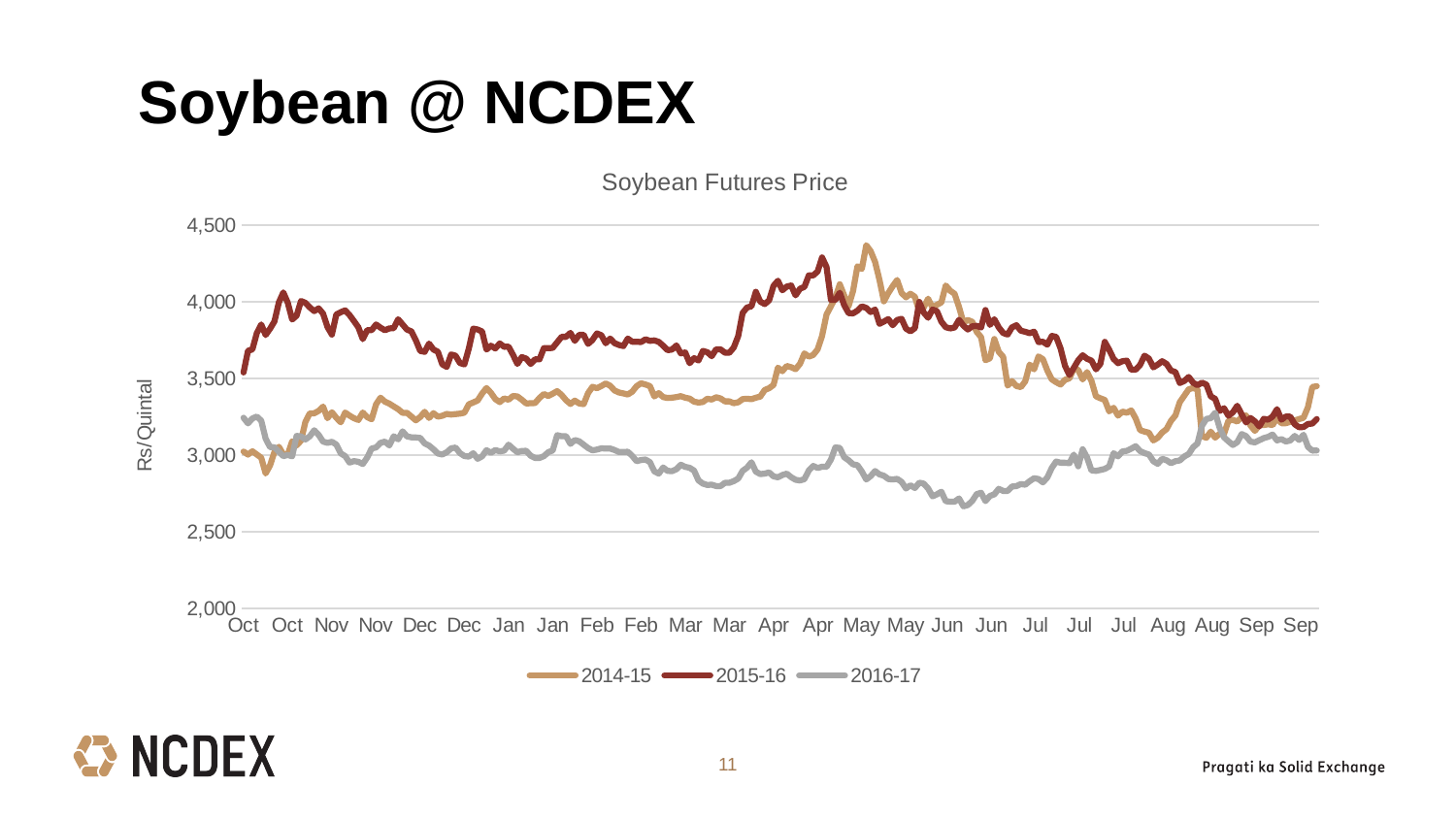
What is the label on the vertical axis of the chart? Rs/Quintal In Jan, which series has the higher value, 2015-16 or 2016-17? 2015-16 Is the value for the 2015-16 series in Nov greater or less than 3,500? greater Is the peak value of the 2014-15 series in May greater or less than 4,000? greater Which series has the lowest values across most of the chart? 2016-17 How many series does the legend of the Soybean Futures Price chart list? 3 What is the title of the chart? Soybean Futures Price Does the 2016-17 series rise or fall from Jun to Sep? rise What kind of chart is shown on the slide? line chart Is the value for the 2016-17 series in Jun greater or less than 3,000? less Does the 2015-16 series rise or fall from Apr to Sep? fall